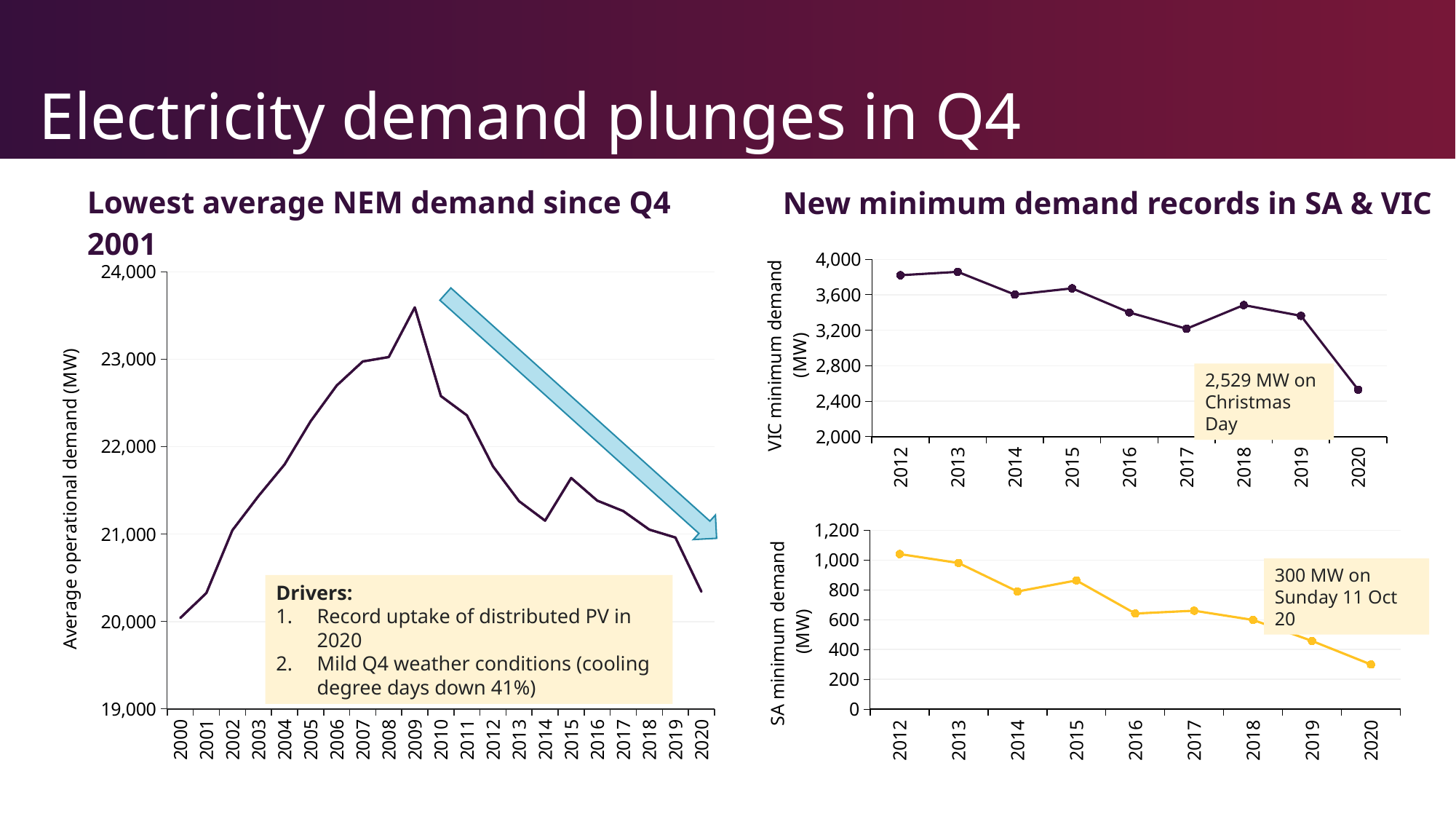
On the SA minimum demand chart (bottom right), what is the minimum demand value for 2020? 300 MW On the VIC minimum demand chart (top right), which year has the lowest value? 2020 On the 'Lowest average NEM demand since Q4 2001' chart, is the value for 2020 greater or less than 21,000? less What kind of chart is the 'Lowest average NEM demand since Q4 2001' chart on the left? Line chart On the VIC minimum demand chart (top right), what is the minimum demand value for 2020? 2,529 MW On the VIC minimum demand chart (top right), how many data points are plotted? 9 On the VIC minimum demand chart (top right), which is larger, the value for 2013 or the value for 2017? 2013 On the 'Lowest average NEM demand since Q4 2001' chart, is the value for 2009 greater or less than 23,000? greater On the SA minimum demand chart (bottom right), which year has the highest value? 2012 On the 'Lowest average NEM demand since Q4 2001' chart, how many years are plotted along the x axis? 21 On the 'Lowest average NEM demand since Q4 2001' chart, which year has the highest average operational demand? 2009 On the SA minimum demand chart (bottom right), do the values generally rise or fall from 2012 to 2020? fall